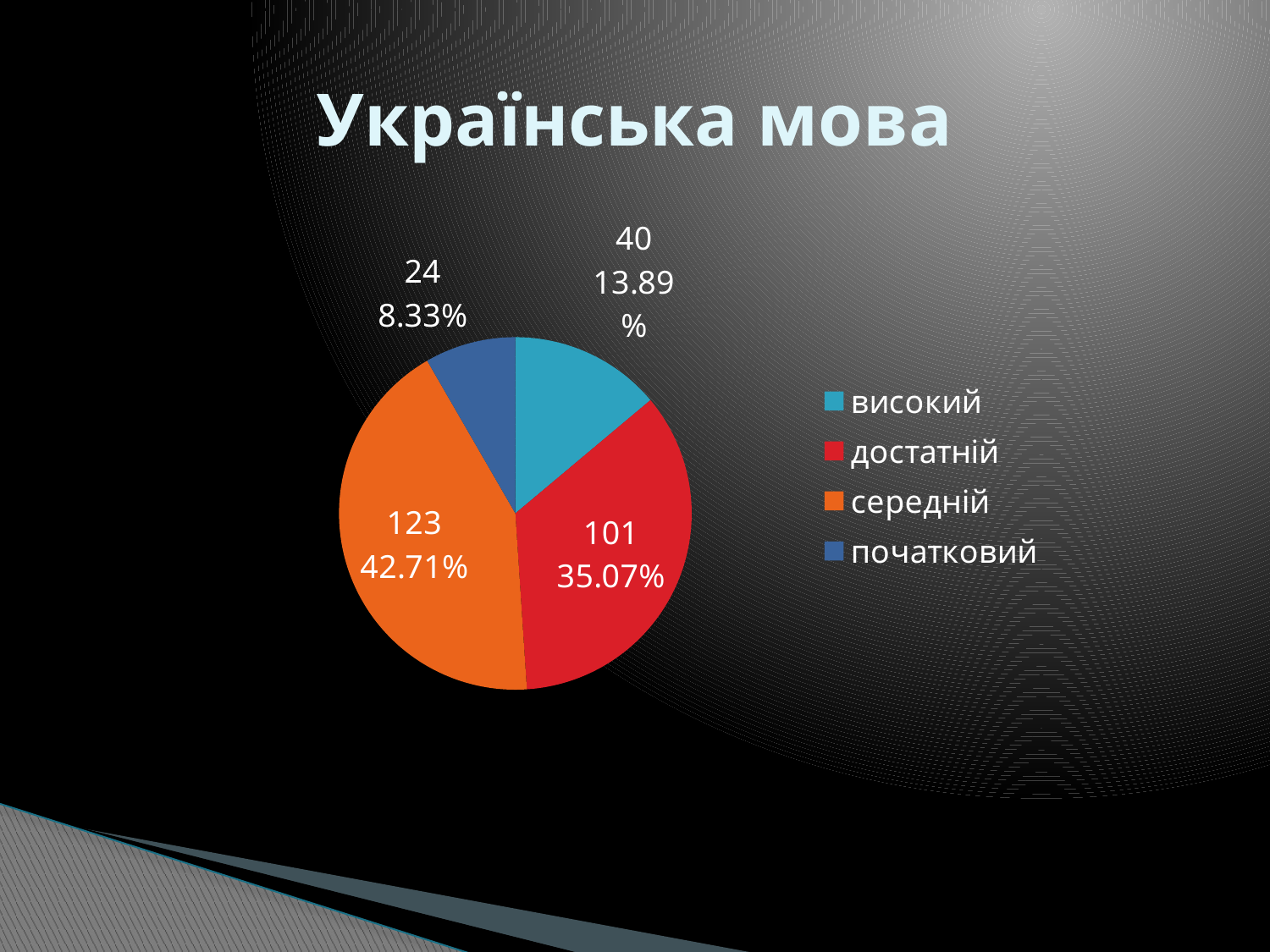
What is the value for початковий? 24 What kind of chart is shown on the slide? pie chart Which category has the smallest slice? початковий What is the value for середній? 123 Which category has the largest slice? середній What is the title of the slide? Українська мова What percentage share does достатній have? 35.07% What is the difference between the values for середній and достатній? 22 What is the value for високий? 40 What percentage share does початковий have? 8.33% Which is larger, the value for високий or the value for початковий? високий How many categories does the legend list? 4